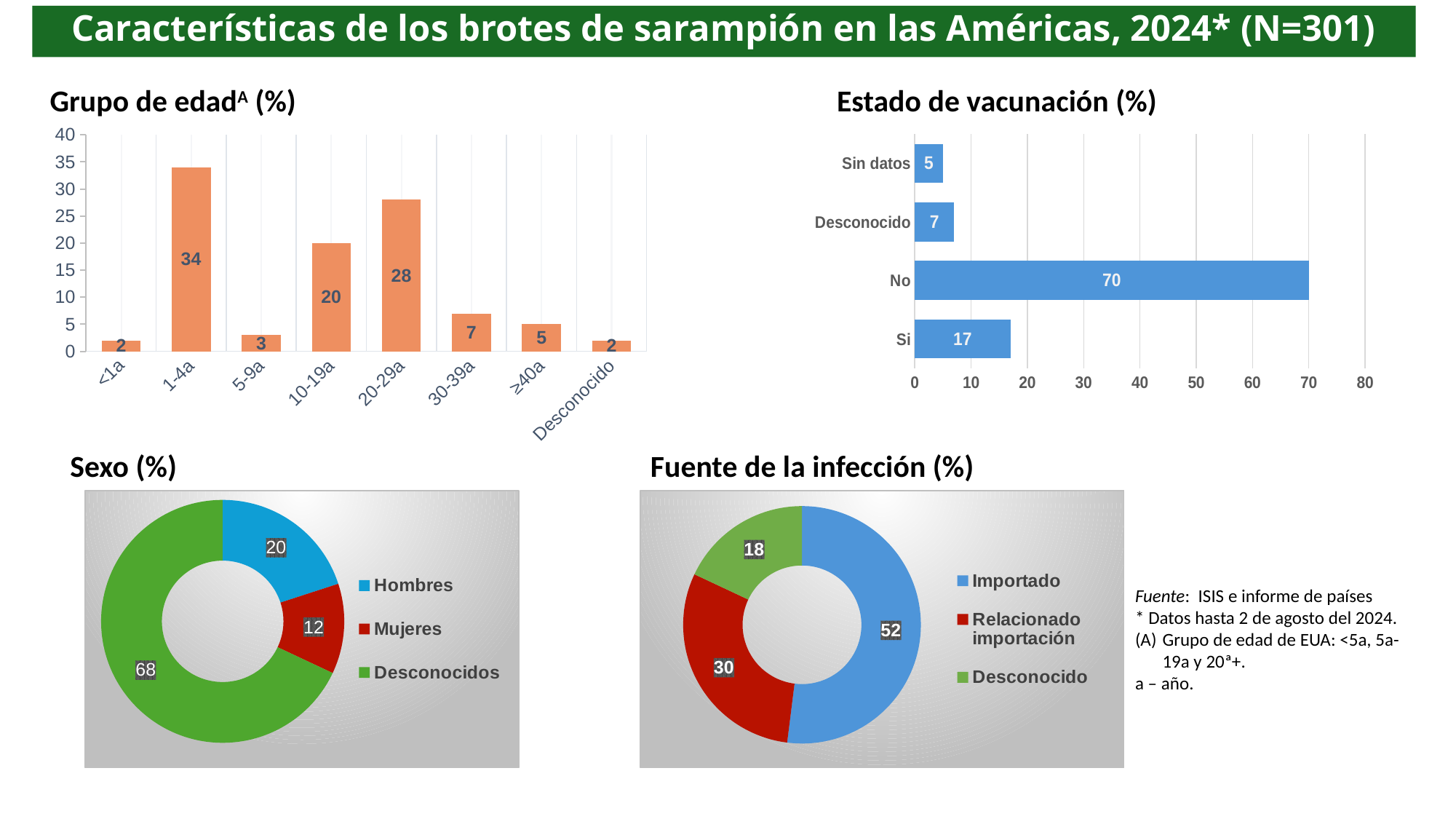
In the 'Estado de vacunación (%)' chart, which is larger, the value for 'Si' or the value for 'Desconocido'? Si In the 'Grupo de edad (%)' chart, which age group has the highest value? 1-4a In the 'Sexo (%)' chart, how many entries does the legend list? 3 In the 'Sexo (%)' chart, what is the value for Mujeres? 12 In the 'Fuente de la infección (%)' chart, what is the value for Importado? 52 In the 'Estado de vacunación (%)' chart, what is the value for 'No'? 70 In the 'Fuente de la infección (%)' chart, what colour is the 'Relacionado importación' slice? Red What kind of chart is the 'Estado de vacunación (%)' chart? Bar chart In the 'Grupo de edad (%)' chart, what is the value for the 1-4a age group? 34 In the 'Estado de vacunación (%)' chart, which category has the lowest value? Sin datos In the 'Grupo de edad (%)' chart, what is the difference between the values for 20-29a and 10-19a? 8 In the 'Grupo de edad (%)' chart, how many categories are shown on the x axis? 8